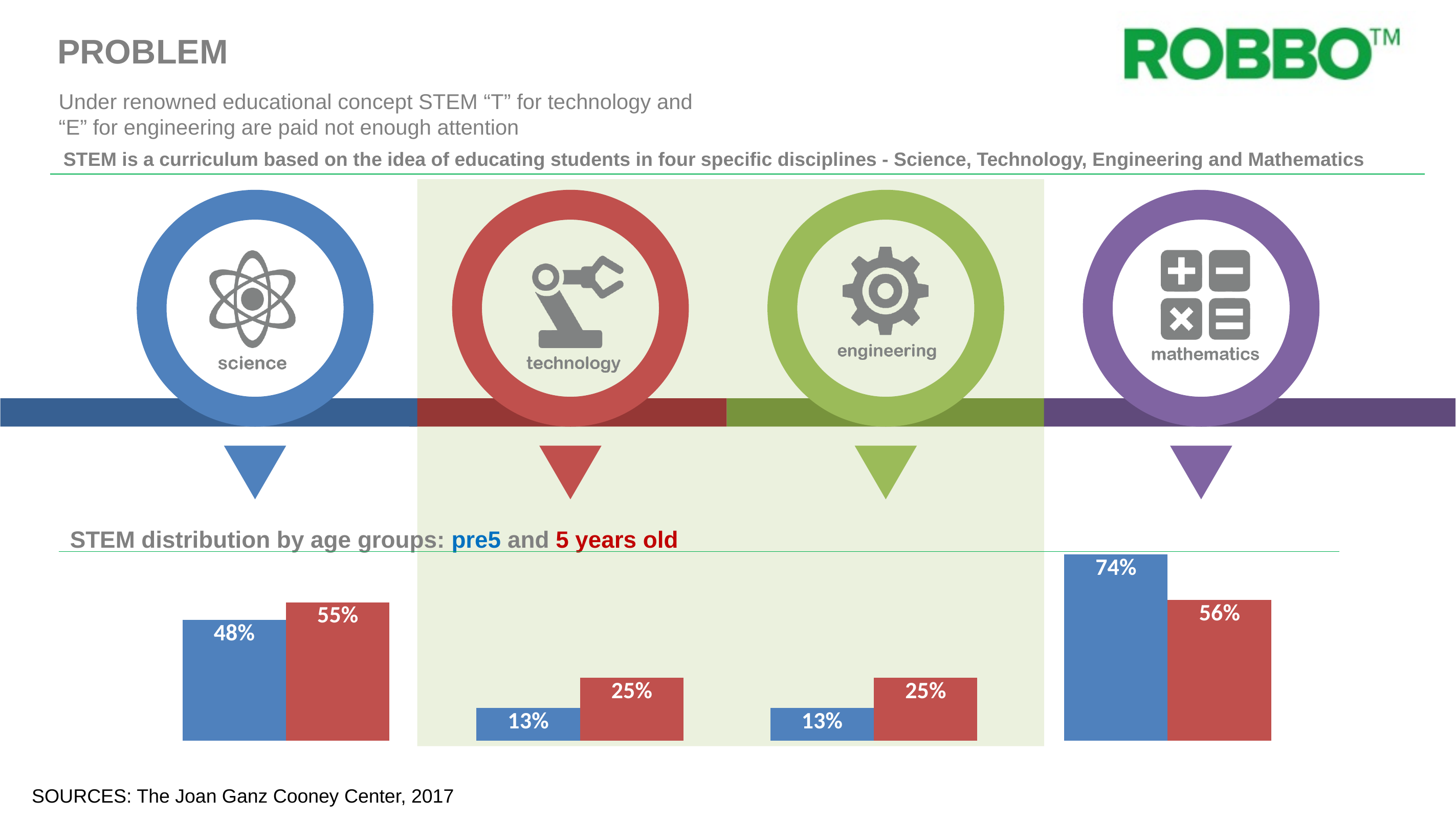
How many age groups (series) does the STEM distribution chart show? 2 What is the 5 years old value for engineering in the STEM distribution chart? 25% For science, which is larger: the pre5 value or the 5 years old value? 5 years old Which discipline has the highest pre5 value in the STEM distribution chart? mathematics How many disciplines are shown in the STEM distribution chart? 4 What is the pre5 value for technology in the STEM distribution chart? 13% What is the pre5 value for science in the STEM distribution chart? 48% What type of chart is the STEM distribution by age groups chart? bar chart What is the difference between the pre5 and 5 years old values for mathematics? 18% What is the difference between the 5 years old and pre5 values for science? 7% What is the 5 years old value for mathematics in the STEM distribution chart? 56% Which discipline has the lowest 5 years old value in the STEM distribution chart? technology and engineering (both 25%)